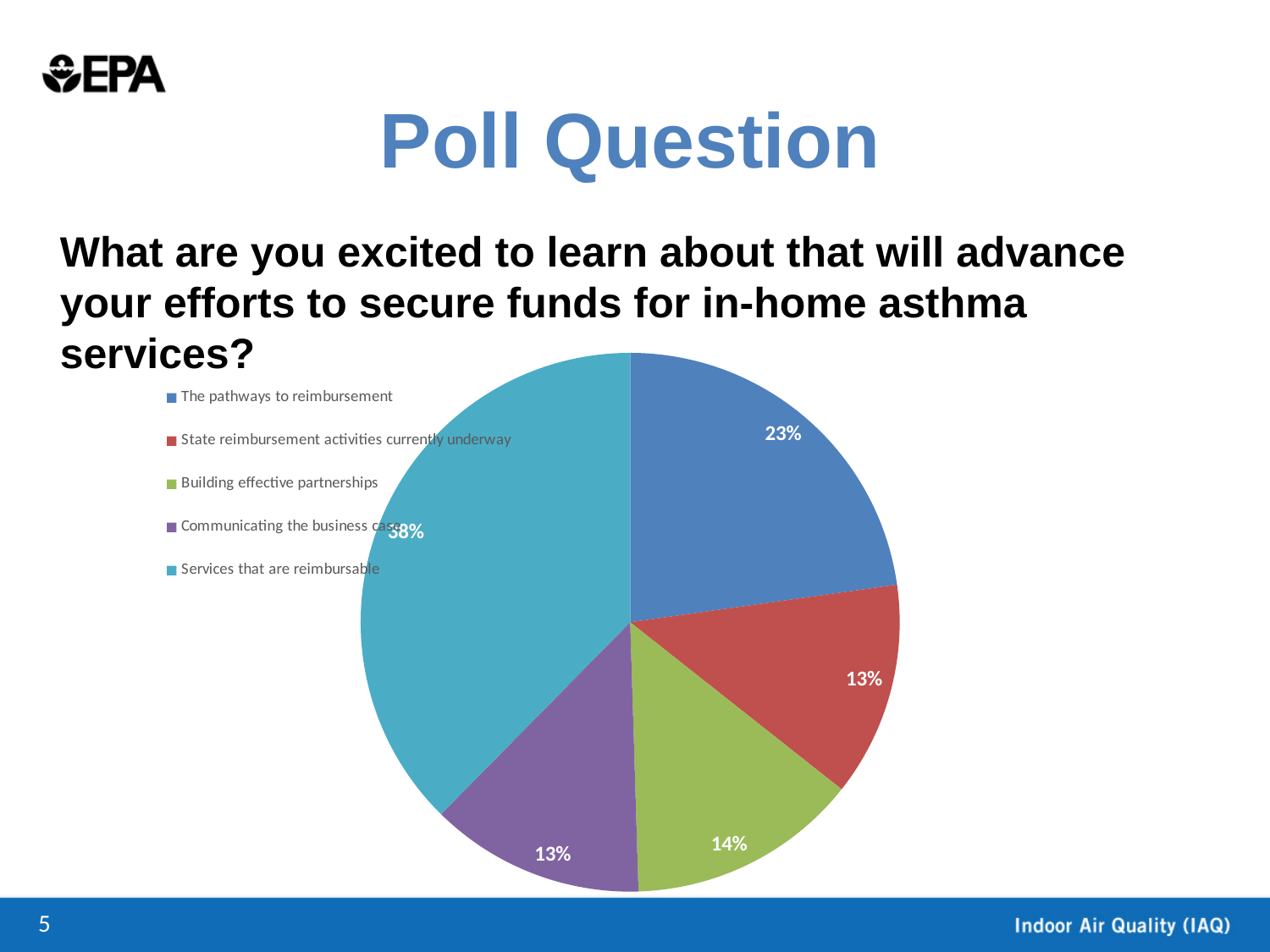
What percentage of respondents chose "State reimbursement activities currently underway"? 13% What percentage of respondents chose "Services that are reimbursable"? 38% What percentage of respondents chose "Communicating the business case"? 13% Which option received the largest share of responses? Services that are reimbursable What percentage of respondents chose "The pathways to reimbursement"? 23% How many entries does the legend list? 5 What percentage of respondents chose "Building effective partnerships"? 14% What type of chart is shown on the slide? pie chart How many options are shown in the pie chart? 5 What colour is the slice for "Communicating the business case"? purple What is the difference in percentage points between "Services that are reimbursable" and "The pathways to reimbursement"? 15 Which received a larger share: "The pathways to reimbursement" or "Building effective partnerships"? The pathways to reimbursement